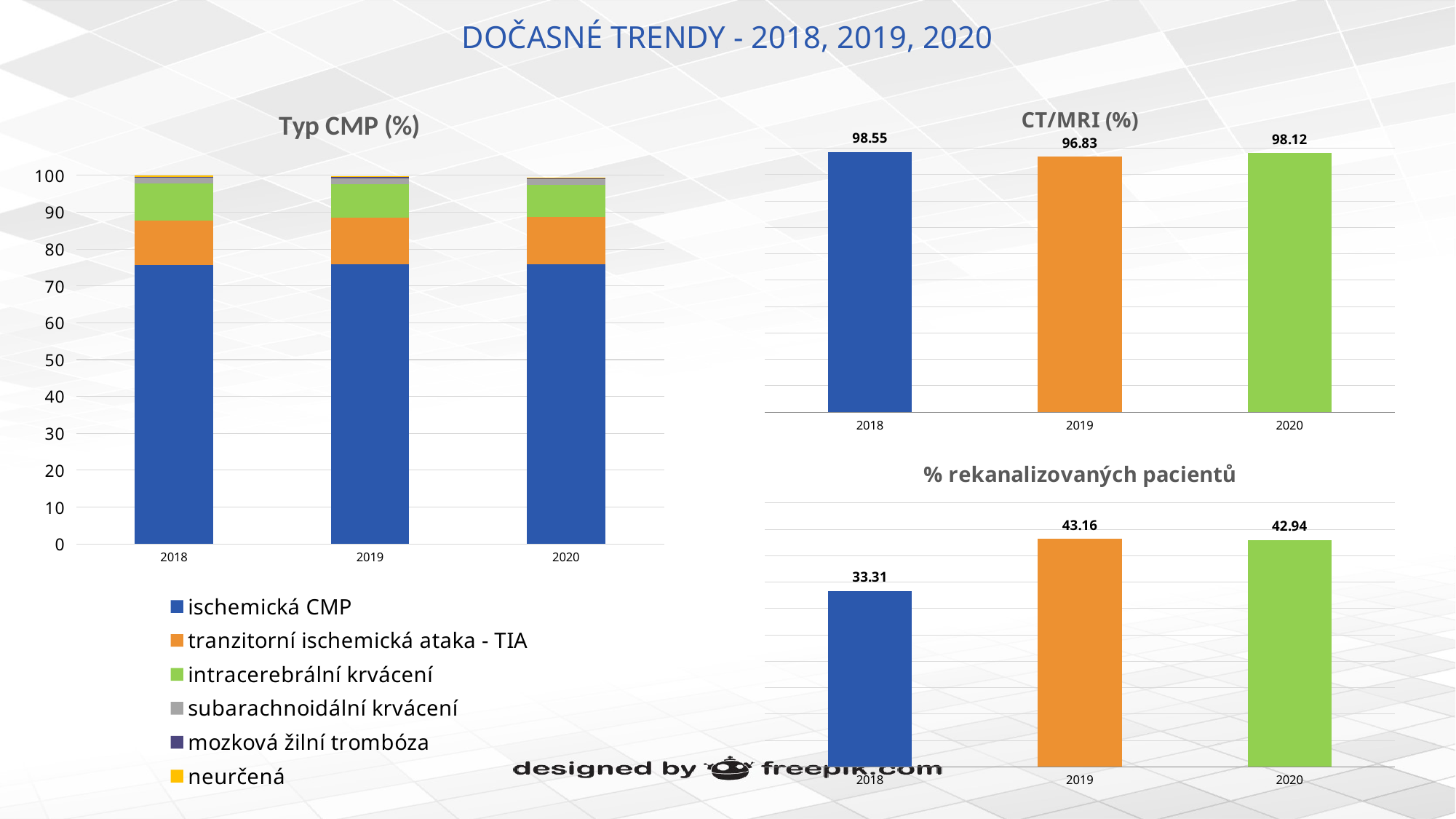
In the % rekanalizovaných pacientů chart, what is the value for 2018? 33.31 In the Typ CMP (%) chart, is the ischemická CMP value for 2018 greater or less than 70? greater How many series does the legend of the Typ CMP (%) chart list? 6 In the CT/MRI (%) chart, which year has the lowest value? 2019 What kind of chart is the Typ CMP (%) chart? stacked bar chart In the % rekanalizovaných pacientů chart, which year has the highest value? 2019 In the % rekanalizovaných pacientů chart, is the value for 2020 larger or smaller than the value for 2018? larger In the % rekanalizovaných pacientů chart, what is the difference between the 2019 and 2018 values? 9.85 In the CT/MRI (%) chart, what is the difference between the 2018 and 2020 values? 0.43 In the CT/MRI (%) chart, what is the value for 2019? 96.83 In the CT/MRI (%) chart, which year has the highest value? 2018 How many years are shown on the x axis of the CT/MRI (%) chart? 3